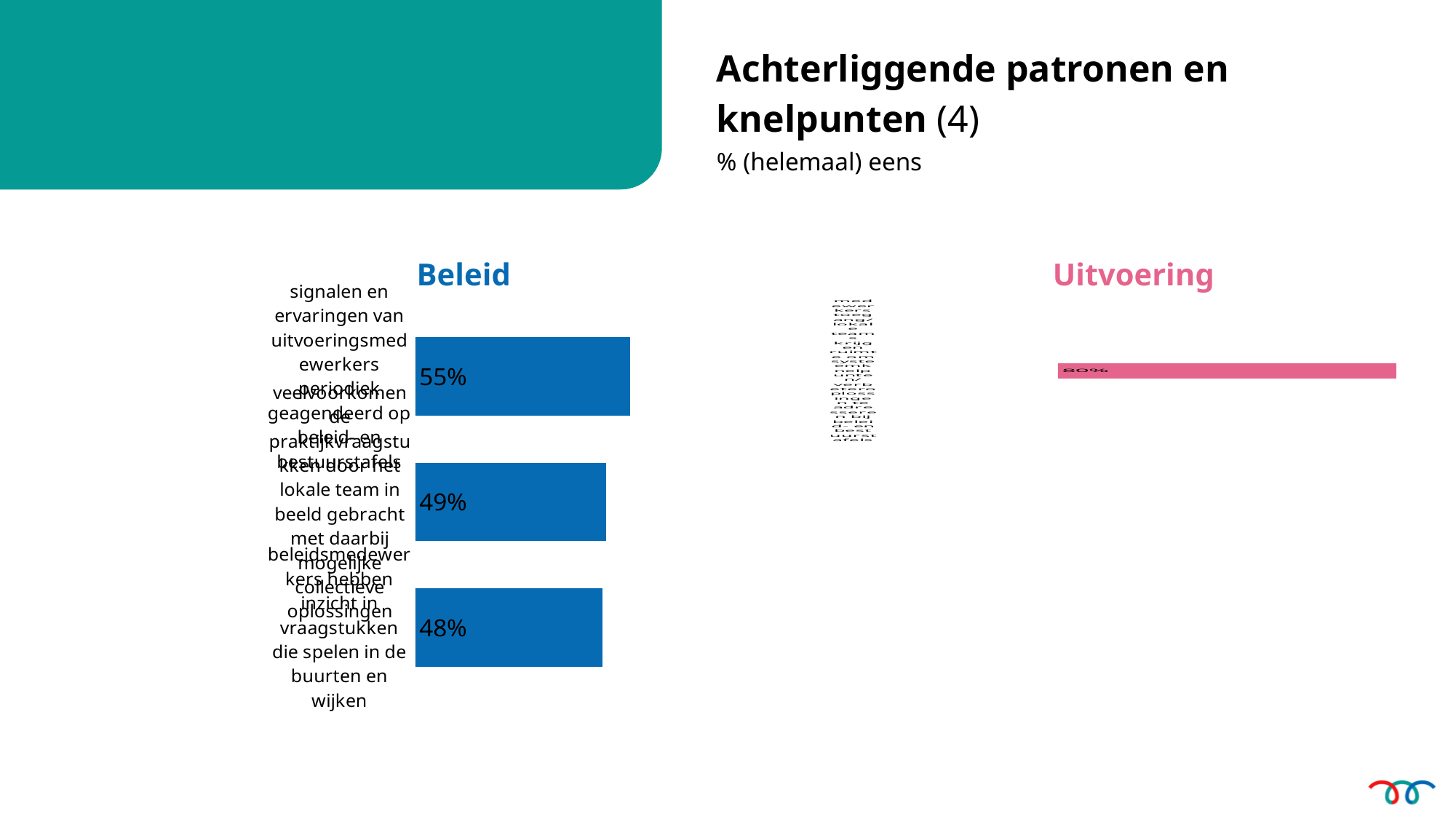
In the Beleid chart, what value is shown on the top bar? 55% In the Beleid chart, what value is shown on the bottom bar? 48% In the Beleid chart, which bar has the lowest value? The bottom bar (48%) In the Beleid chart, which bar has the highest value? The top bar (55%) In the Uitvoering chart, what value is shown on the bar? 80% What type of chart is the Beleid chart? Bar chart In the Beleid chart, what is the difference between the top bar and the bottom bar? 7 percentage points In the Beleid chart, what is the difference between the top bar and the middle bar? 6 percentage points In the Beleid chart, what value is shown on the middle bar? 49% How many bars are plotted in the Beleid chart? 3 Which is larger: the top bar of the Beleid chart or the bar in the Uitvoering chart? The Uitvoering bar (80%) What colour are the bars in the Beleid chart? Blue